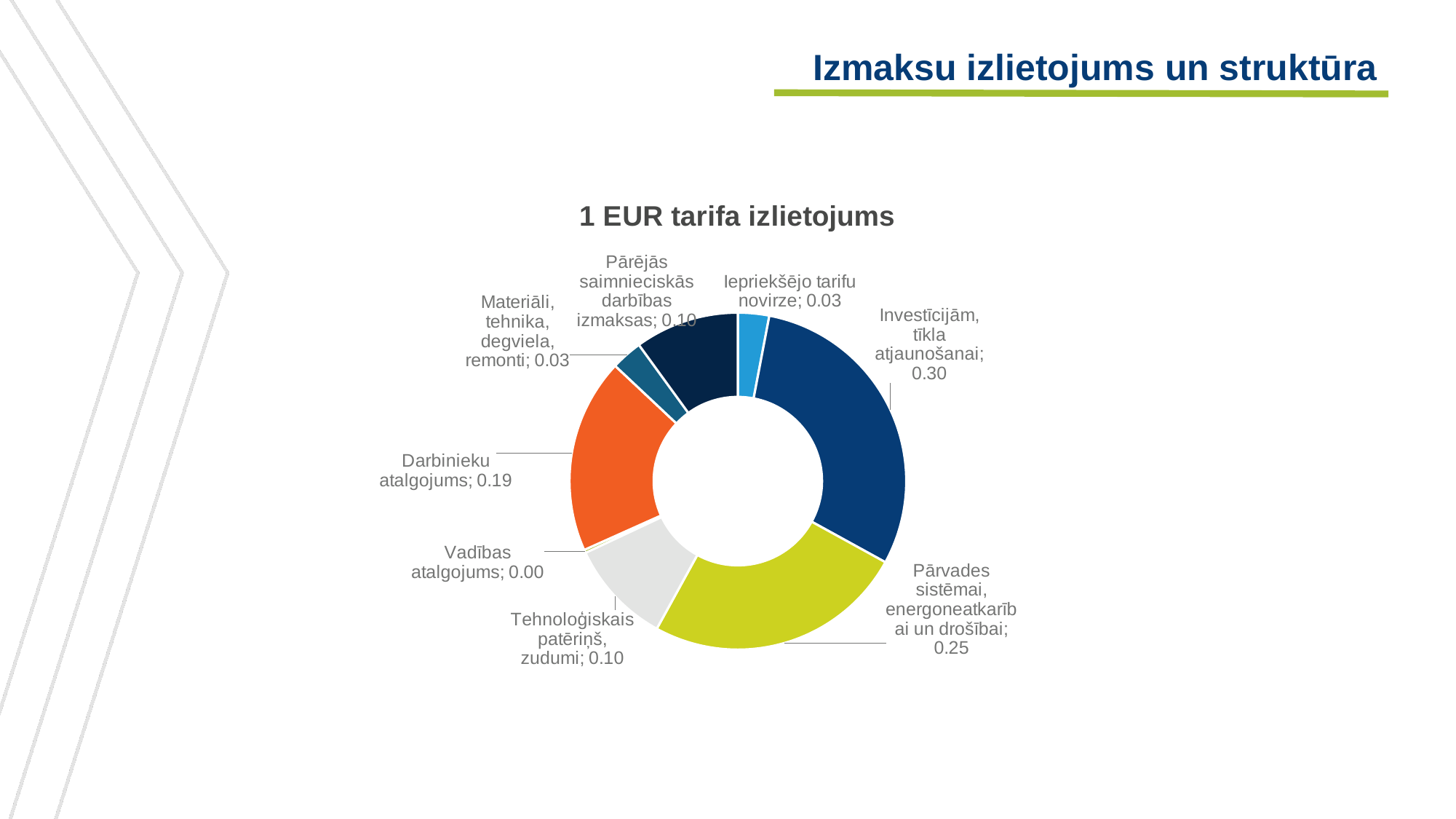
What is the value for "Vadības atalgojums" in the chart? 0.00 What is the value for "Iepriekšējo tarifu novirze" in the chart? 0.03 Which category has the smallest value in the chart? Vadības atalgojums What kind of chart is shown on the slide? Doughnut (pie) chart What is the value for "Investīcijām, tīkla atjaunošanai" in the chart? 0.30 What is the title of the chart? 1 EUR tarifa izlietojums What is the value for "Tehnoloģiskais patēriņš, zudumi" in the chart? 0.10 How many categories are shown in the chart? 8 What is the difference between the values for "Investīcijām, tīkla atjaunošanai" and "Pārvades sistēmai, energoneatkarībai un drošībai"? 0.05 Which is larger: the value for "Darbinieku atalgojums" or the value for "Pārējās saimnieciskās darbības izmaksas"? Darbinieku atalgojums Which category has the largest value in the chart? Investīcijām, tīkla atjaunošanai What is the value for "Darbinieku atalgojums" in the chart? 0.19